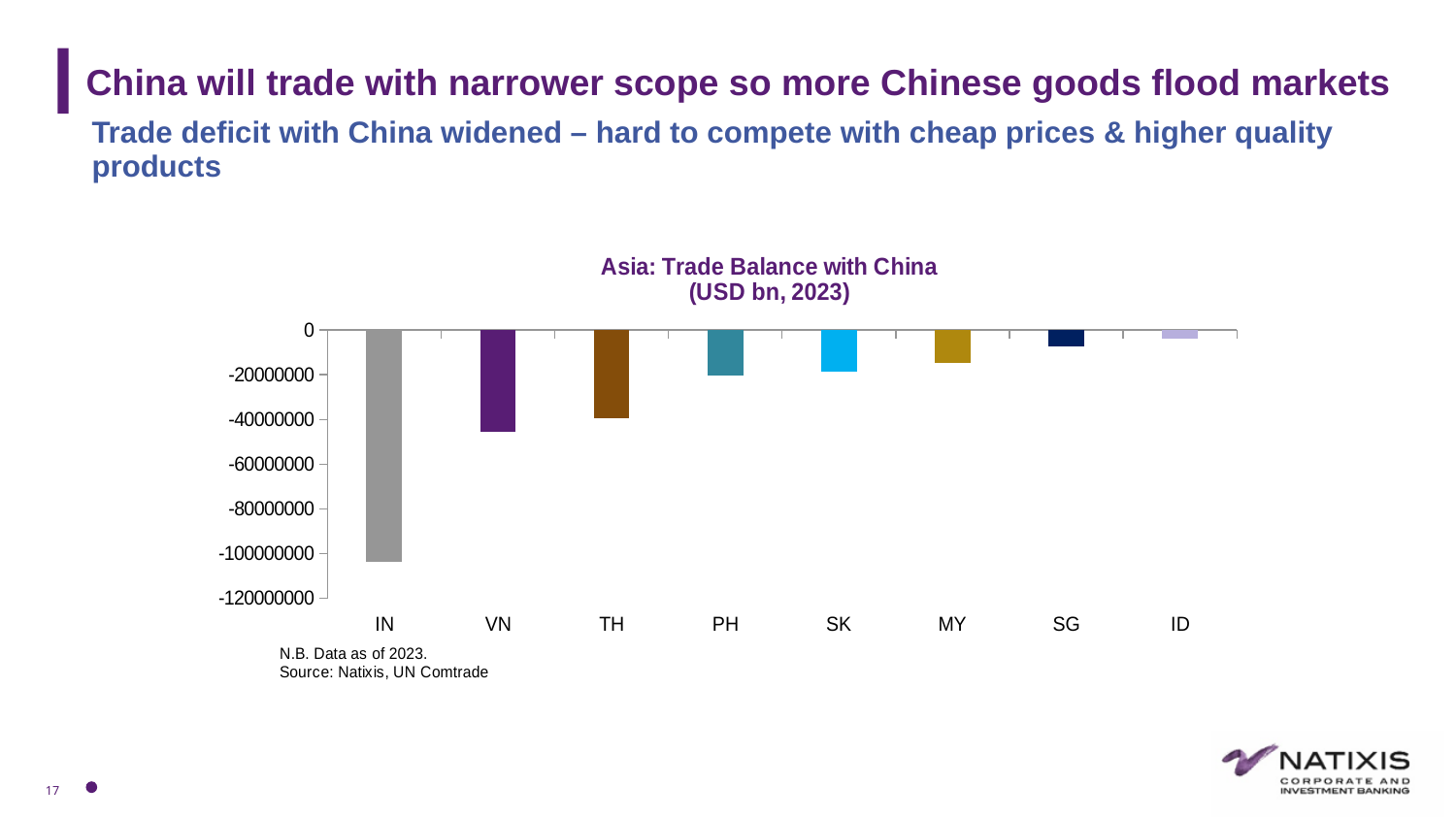
Is the value for PH greater or less than -40000000? greater Which has the larger (less negative) trade balance with China, VN or TH? TH What type of chart is shown on the slide? bar chart What is the title of the chart? Asia: Trade Balance with China (USD bn, 2023) Is the value for IN greater or less than -80000000? less Is the value for MY greater or less than -20000000? greater Do the values generally rise or fall moving from IN to ID along the x axis? rise How many countries are shown on the x axis of the chart? 8 Which country has the lowest (most negative) trade balance with China in the chart? IN